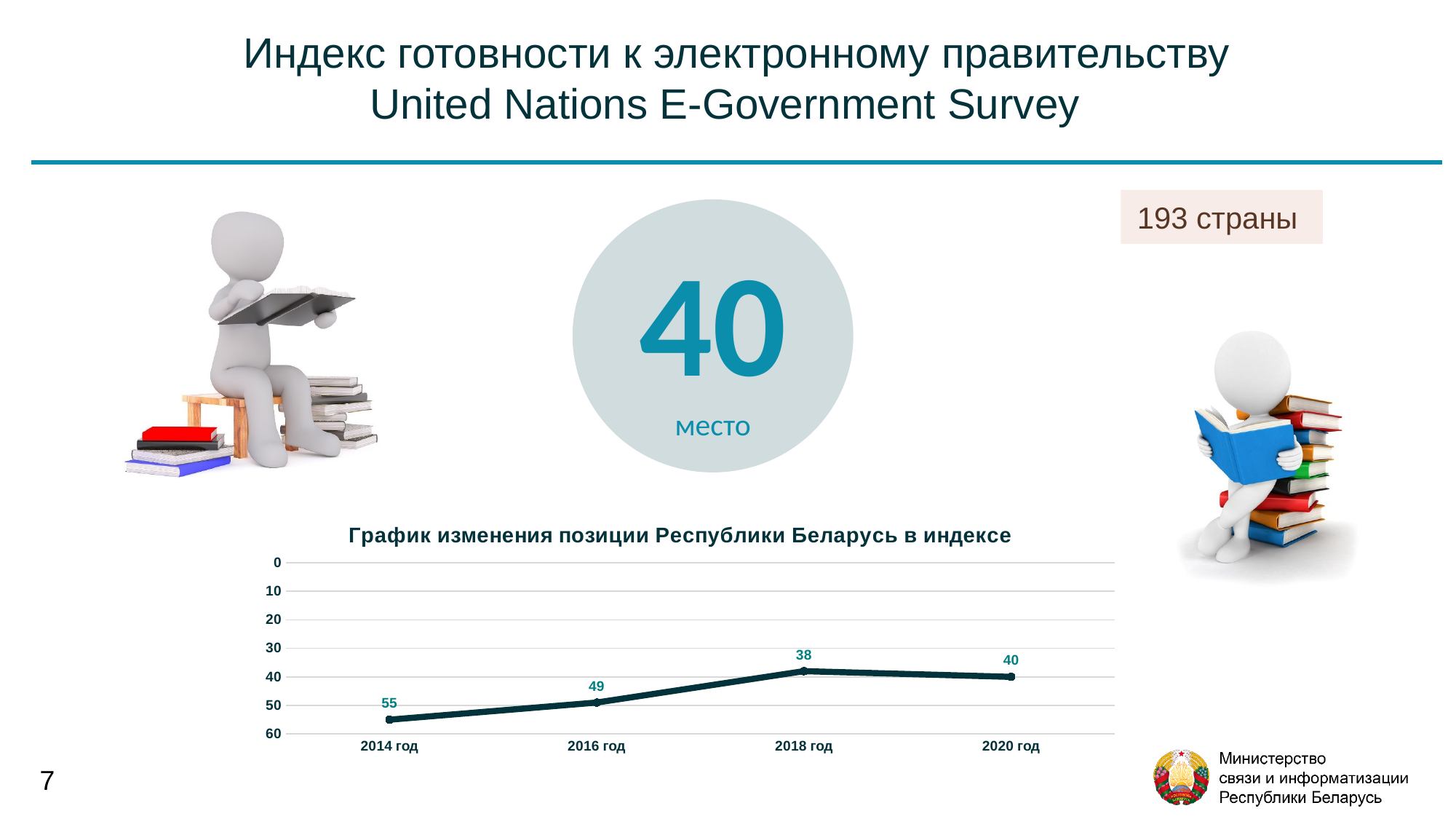
Which is numerically larger, the value for 2018 год or the value for 2020 год? 2020 год What is the difference between the values for 2014 год and 2020 год? 15 How many data points are plotted on the chart? 4 Which year has the highest numerical value on the chart? 2014 год What is the value for 2016 год on the chart? 49 Which year has the lowest numerical value on the chart? 2018 год What is the value for 2020 год on the chart? 40 What is the title of the chart? График изменения позиции Республики Беларусь в индексе What is the difference between the values for 2016 год and 2018 год? 11 What kind of chart is shown on the slide? Line chart What is the value for 2014 год on the chart? 55 What is the value for 2018 год on the chart? 38